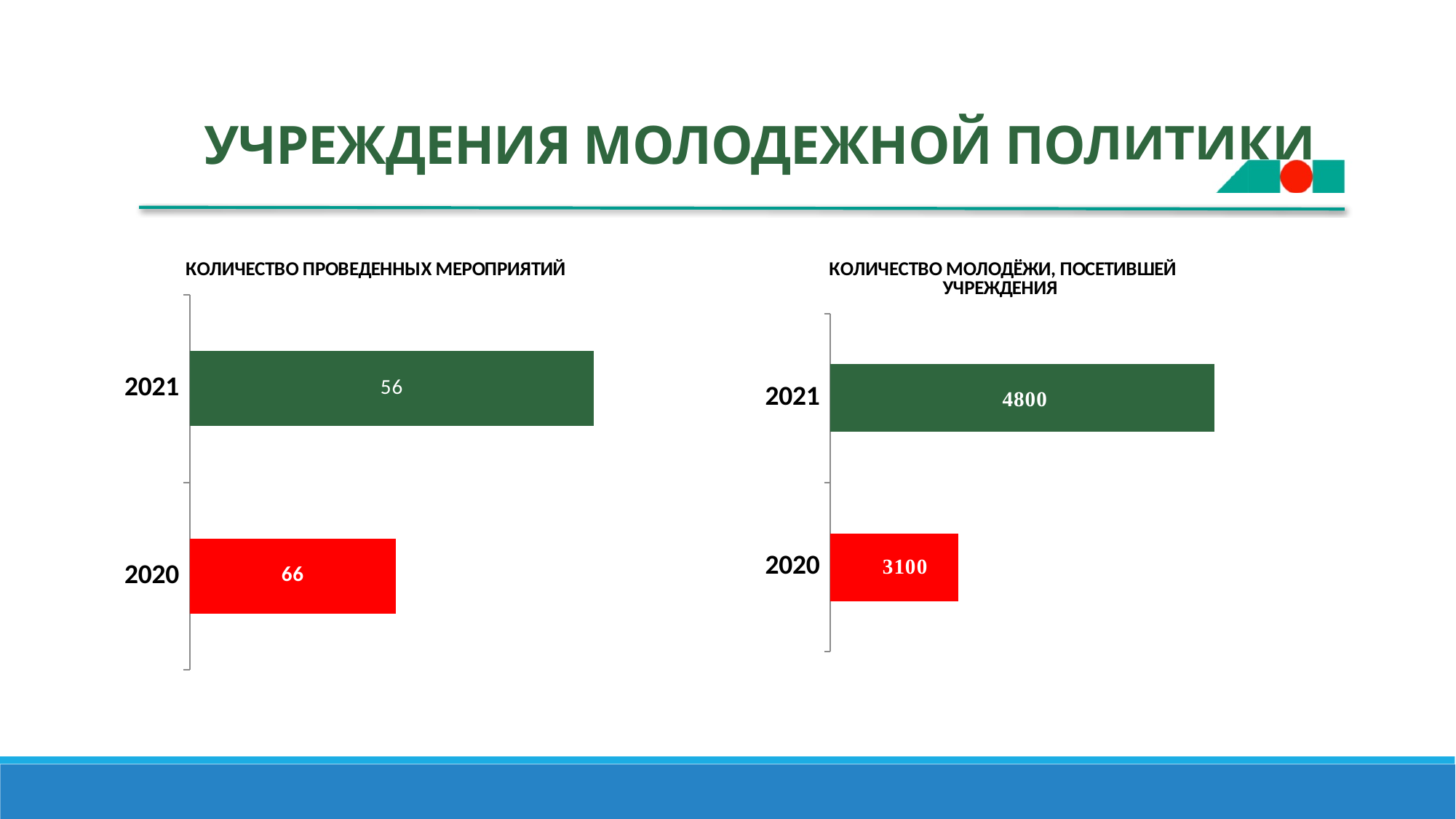
In the chart titled 'КОЛИЧЕСТВО МОЛОДЁЖИ, ПОСЕТИВШЕЙ УЧРЕЖДЕНИЯ', which year has the highest value? 2021 In the chart titled 'КОЛИЧЕСТВО ПРОВЕДЕННЫХ МЕРОПРИЯТИЙ', what colour is the bar for 2020? Red How many categories does the chart titled 'КОЛИЧЕСТВО ПРОВЕДЕННЫХ МЕРОПРИЯТИЙ' show? 2 In the chart titled 'КОЛИЧЕСТВО ПРОВЕДЕННЫХ МЕРОПРИЯТИЙ', what is the difference between the labelled values for 2020 and 2021? 10 In the chart titled 'КОЛИЧЕСТВО МОЛОДЁЖИ, ПОСЕТИВШЕЙ УЧРЕЖДЕНИЯ', what is the value for 2021? 4800 In the chart titled 'КОЛИЧЕСТВО ПРОВЕДЕННЫХ МЕРОПРИЯТИЙ', what is the value for 2020? 66 In the chart titled 'КОЛИЧЕСТВО МОЛОДЁЖИ, ПОСЕТИВШЕЙ УЧРЕЖДЕНИЯ', which is larger, the value for 2021 or the value for 2020? 2021 In the chart titled 'КОЛИЧЕСТВО МОЛОДЁЖИ, ПОСЕТИВШЕЙ УЧРЕЖДЕНИЯ', what is the difference between the values for 2021 and 2020? 1700 In the chart titled 'КОЛИЧЕСТВО ПРОВЕДЕННЫХ МЕРОПРИЯТИЙ', what is the value for 2021? 56 What kind of chart is the chart titled 'КОЛИЧЕСТВО МОЛОДЁЖИ, ПОСЕТИВШЕЙ УЧРЕЖДЕНИЯ'? Bar chart In the chart titled 'КОЛИЧЕСТВО МОЛОДЁЖИ, ПОСЕТИВШЕЙ УЧРЕЖДЕНИЯ', what is the value for 2020? 3100 In the chart titled 'КОЛИЧЕСТВО МОЛОДЁЖИ, ПОСЕТИВШЕЙ УЧРЕЖДЕНИЯ', which year has the lowest value? 2020